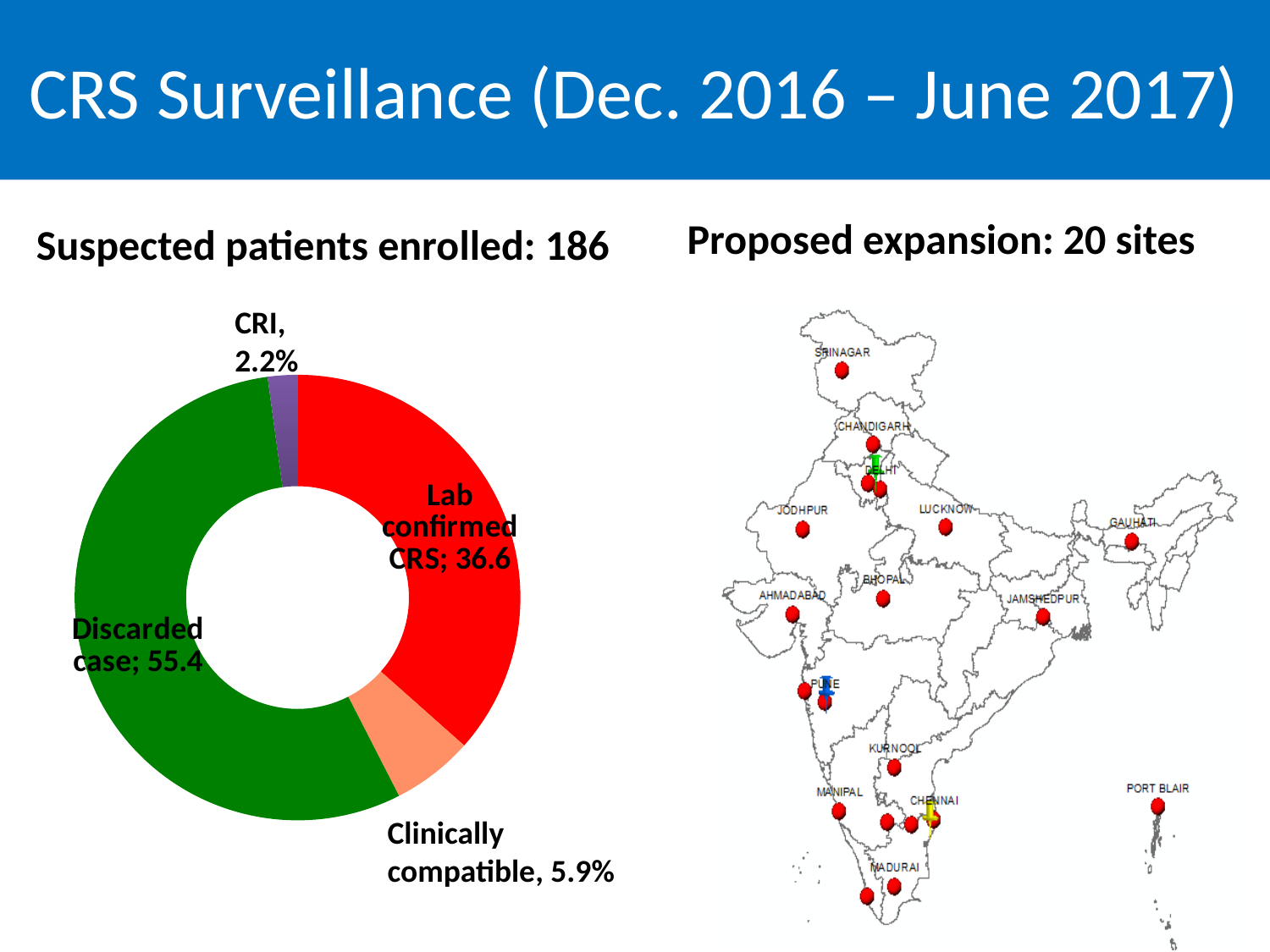
In the doughnut chart, what is the difference between the Discarded case value and the Lab confirmed CRS value? 18.8 In the doughnut chart, which is larger: Clinically compatible or CRI? Clinically compatible What colour is the Discarded case segment in the doughnut chart? Green How many categories are shown in the doughnut chart? 4 In the doughnut chart, which is larger: Lab confirmed CRS or Discarded case? Discarded case Which category has the largest share of the doughnut chart? Discarded case What kind of chart is shown on the left of the slide? Doughnut chart In the doughnut chart, what value is shown for Discarded case? 55.4 Which category has the smallest share of the doughnut chart? CRI In the doughnut chart, what value is shown for Lab confirmed CRS? 36.6 In the doughnut chart, what percentage is shown for CRI? 2.2% In the doughnut chart, what percentage is shown for Clinically compatible? 5.9%